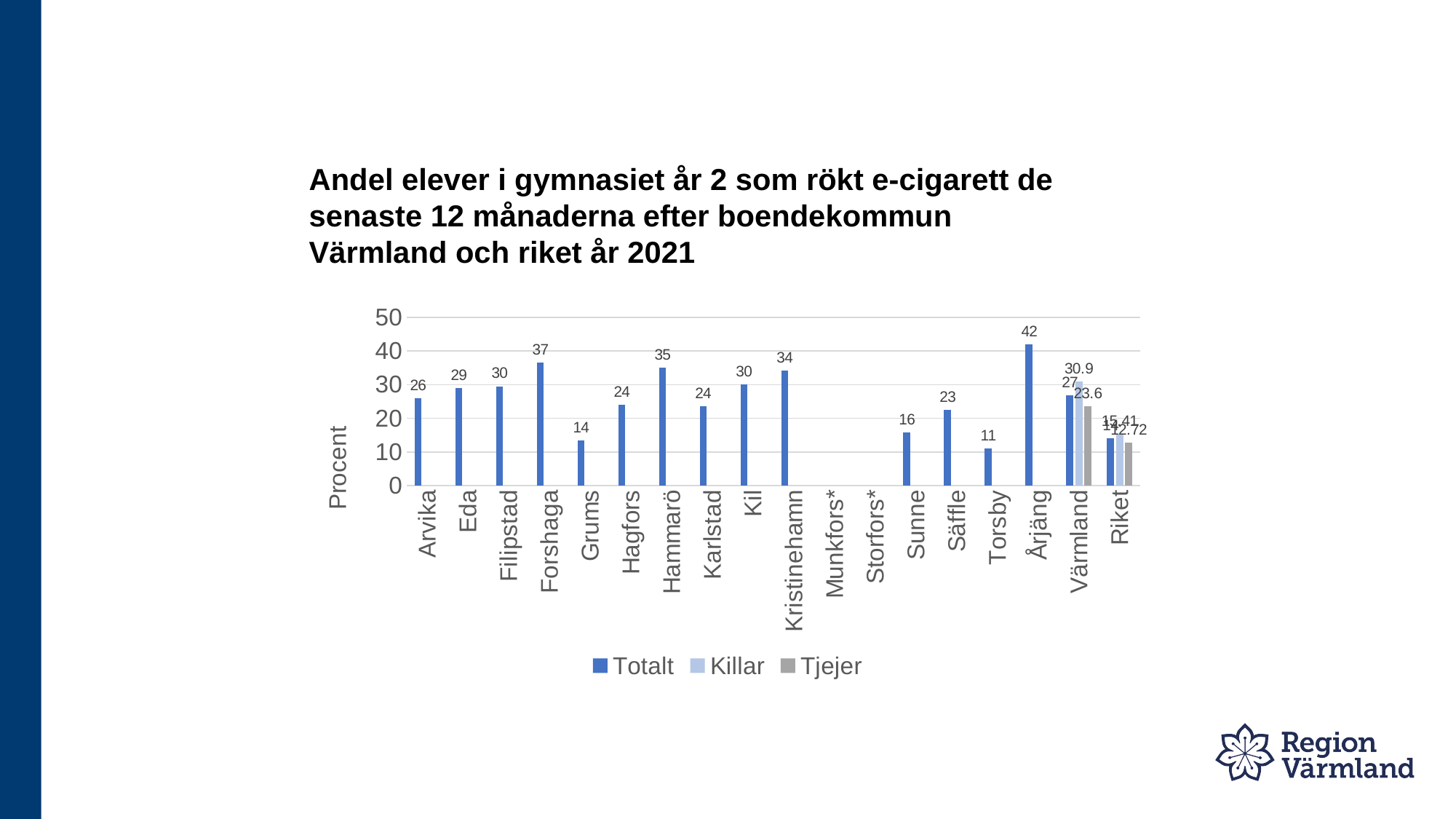
Which has a higher Totalt value, Hammarö or Kristinehamn? Hammarö What is the label on the y axis? Procent Which municipality has the highest Totalt value? Årjäng What is the difference between the Totalt values for Forshaga and Arvika? 11 What is the Totalt value for Årjäng? 42 How many categories are listed on the x axis? 18 Which municipality with a plotted bar has the lowest Totalt value? Torsby How many series does the legend list? 3 What is the Tjejer value for Riket? 12.72 What is the Tjejer value for Värmland? 23.6 What is the Killar value for Värmland? 30.9 What kind of chart is shown on the slide? Bar chart